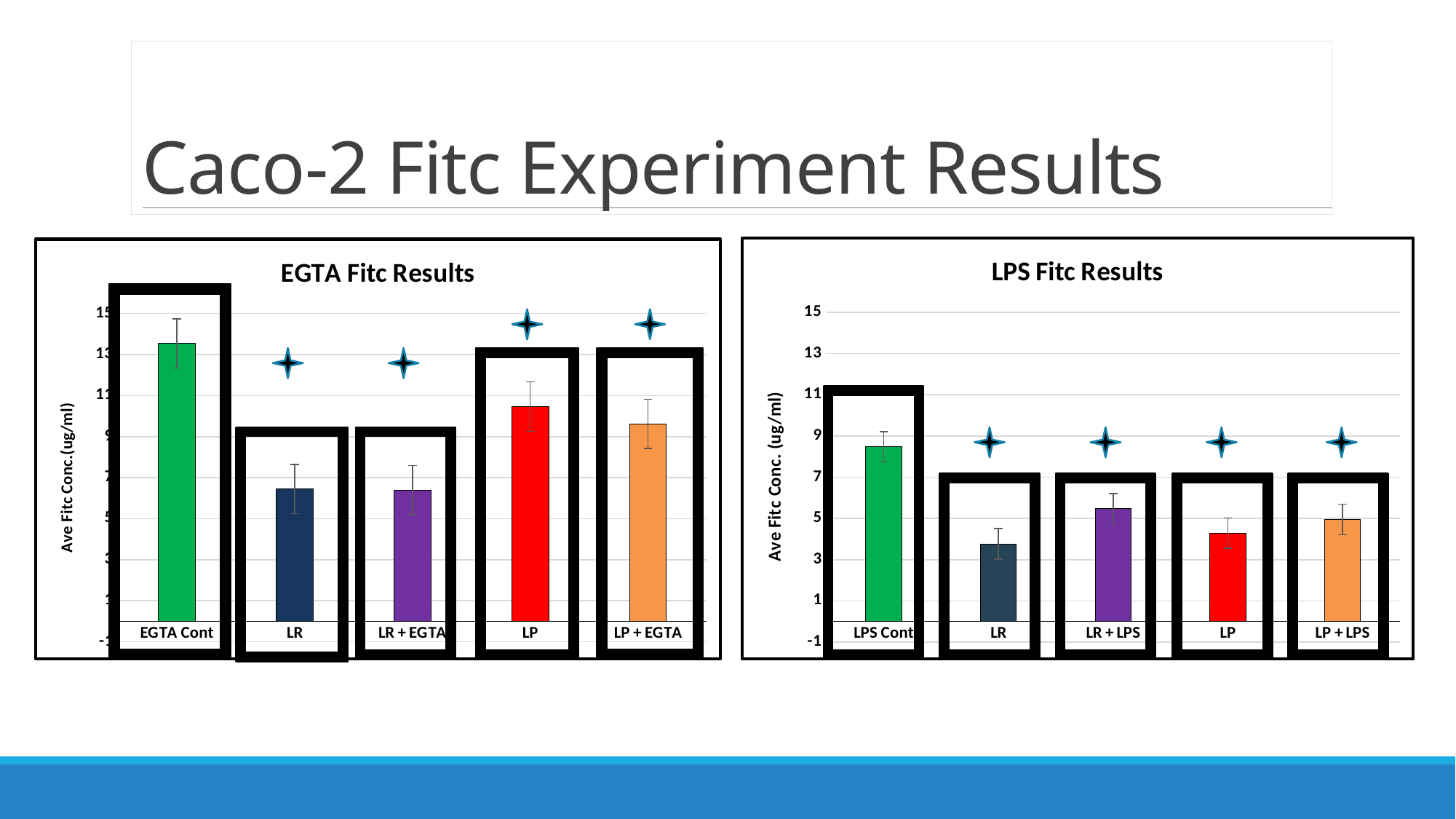
In the LPS Fitc Results chart, which category has the lowest value? LR In the LPS Fitc Results chart, is the value for LR greater or less than 5? less In the EGTA Fitc Results chart, which is larger, the value for LP or the value for LR? LP In the LPS Fitc Results chart, is the value for LPS Cont greater or less than 7? greater In the EGTA Fitc Results chart, is the value for LR greater or less than 7? less What is the y-axis label of the LPS Fitc Results chart? Ave Fitc Conc. (ug/ml) How many categories are shown on the x axis of the LPS Fitc Results chart? 5 In the LPS Fitc Results chart, which category has the highest value? LPS Cont In the LPS Fitc Results chart, which is larger, the value for LR + LPS or the value for LR? LR + LPS What kind of chart is the EGTA Fitc Results chart? bar chart In the EGTA Fitc Results chart, which category has the highest value? EGTA Cont